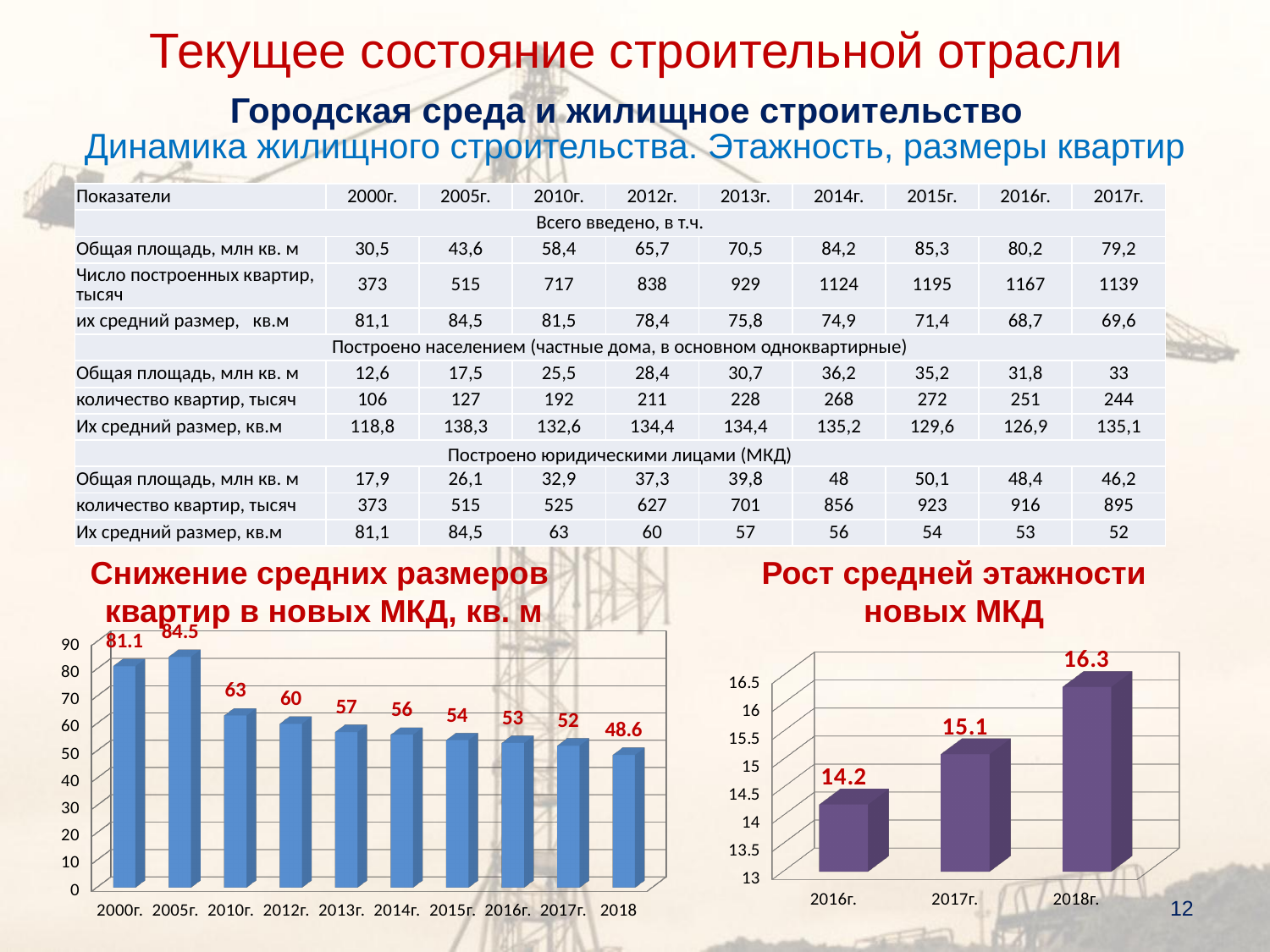
In the chart 'Снижение средних размеров квартир в новых МКД, кв. м', what is the value for 2018? 48.6 In the chart 'Рост средней этажности новых МКД', which is larger, the value for 2016г. or 2017г.? 2017г. In the chart 'Снижение средних размеров квартир в новых МКД, кв. м', do the values generally rise or fall from 2010г. to 2018? fall In the chart 'Снижение средних размеров квартир в новых МКД, кв. м', what is the difference between the values for 2005г. and 2010г.? 21.5 In the chart 'Рост средней этажности новых МКД', what is the difference between the values for 2018г. and 2016г.? 2.1 In the chart 'Рост средней этажности новых МКД', what is the value for 2017г.? 15.1 In the chart 'Снижение средних размеров квартир в новых МКД, кв. м', which year has the lowest value? 2018 In the chart 'Снижение средних размеров квартир в новых МКД, кв. м', how many bars are plotted? 10 What kind of chart is 'Рост средней этажности новых МКД'? bar chart In the chart 'Рост средней этажности новых МКД', how many years are shown on the x axis? 3 In the chart 'Снижение средних размеров квартир в новых МКД, кв. м', what is the value for 2010г.? 63 In the chart 'Снижение средних размеров квартир в новых МКД, кв. м', which year has the highest value? 2005г.